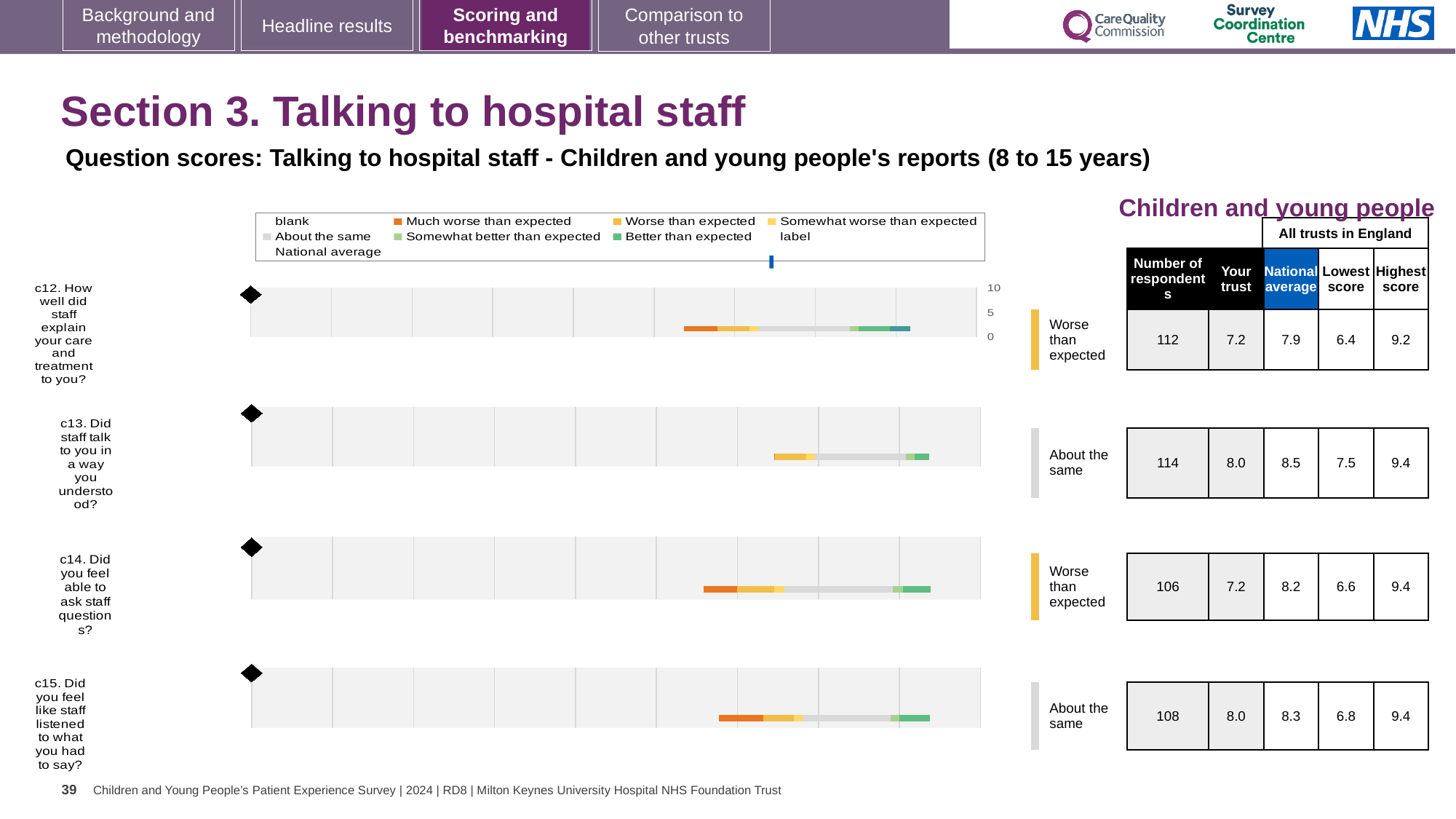
Which has the higher "Your trust" score, c12 or c13? c13 According to the table, what is the lowest score across all trusts in England for c15 (Did you feel like staff listened to what you had to say)? 6.8 Which question has the highest number of respondents in the table? c13 What colour represents "Much worse than expected" in the chart legend? orange How many question charts (c12 to c15) are shown on the slide? 4 According to the table, how many respondents answered c13 (Did staff talk to you in a way you understood)? 114 What benchmark category is shown for c14 (Did you feel able to ask staff questions)? Worse than expected What kind of chart is used to show the benchmark ranges for questions c12 to c15? bar chart According to the table next to the charts, what is the "Your trust" score for c12 (How well did staff explain your care and treatment to you)? 7.2 What is the difference between the national average and the "Your trust" score for c12? 0.7 According to the table, what is the national average for c14 (Did you feel able to ask staff questions)? 8.2 What is the highest tick value shown on the chart axis? 10